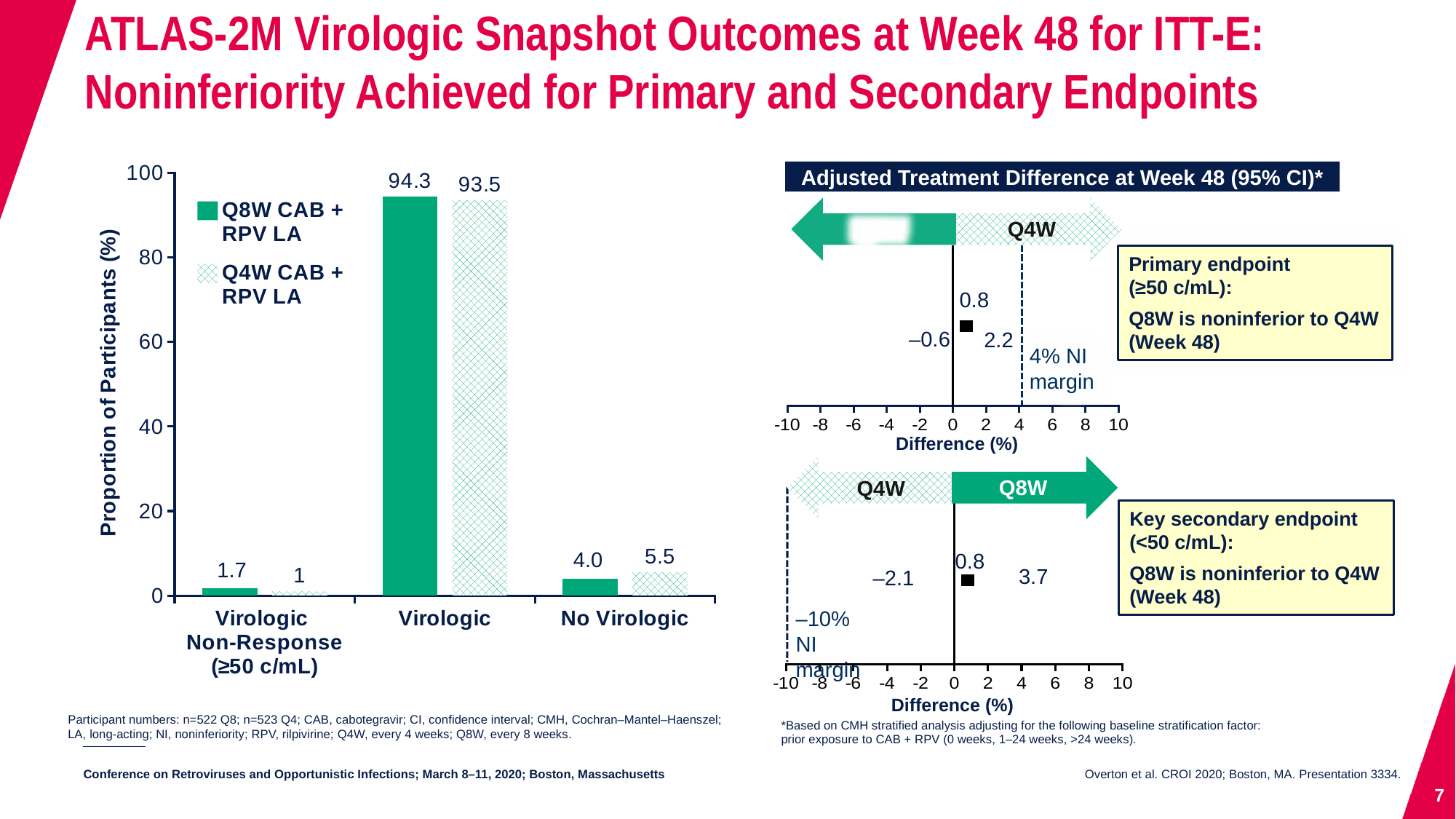
In the bar chart on the left, what is the value for Q4W CAB + RPV LA in the No Virologic category? 5.5 How many series does the legend of the bar chart on the left list? 2 How many categories are shown on the x axis of the bar chart on the left? 3 In the bar chart on the left, which category has the highest value for Q8W CAB + RPV LA? Virologic In the upper Adjusted Treatment Difference chart (primary endpoint), what are the lower and upper bounds of the 95% CI? –0.6 and 2.2 What kind of chart is shown on the left of the slide? bar chart In the bar chart on the left, what is the difference between the Q8W CAB + RPV LA and Q4W CAB + RPV LA values in the Virologic category? 0.8 In the bar chart on the left, what is the difference between the Q4W CAB + RPV LA and Q8W CAB + RPV LA values in the No Virologic category? 1.5 In the bar chart on the left, which series has the larger value in the Virologic Non-Response (≥50 c/mL) category? Q8W CAB + RPV LA In the bar chart on the left, what is the value for Q8W CAB + RPV LA in the Virologic Non-Response (≥50 c/mL) category? 1.7 In the lower Adjusted Treatment Difference chart (key secondary endpoint), what is the point estimate of the difference? 0.8 In the bar chart on the left, what is the value for Q4W CAB + RPV LA in the Virologic category? 93.5